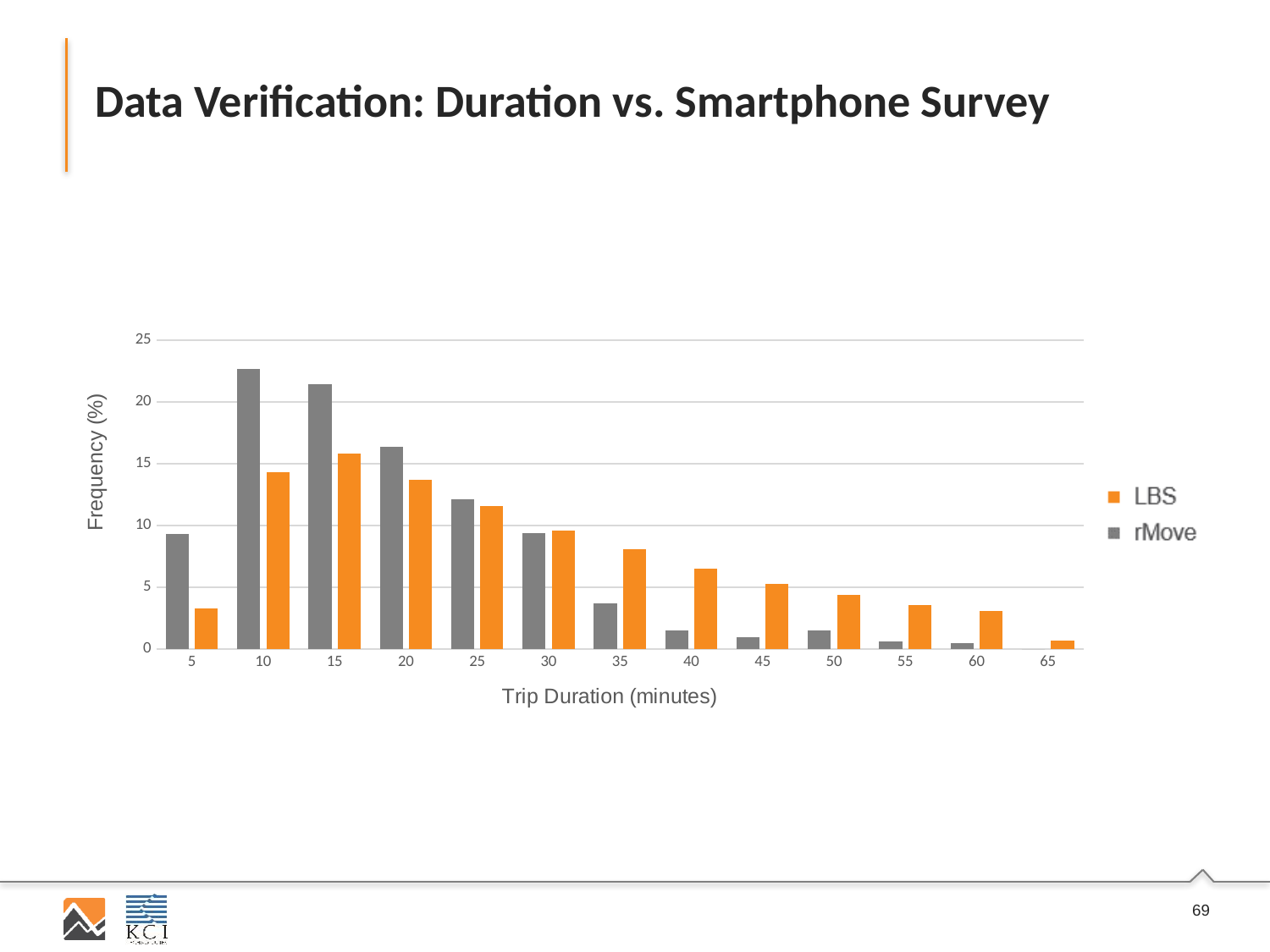
How many series does the legend list? 2 What kind of chart is shown on the slide? bar chart Is the rMove value for trip duration 35 greater or less than 5? less At trip duration 40, which series has the larger value, LBS or rMove? LBS Which trip duration has the lowest LBS frequency? 65 Which trip duration has the highest LBS frequency? 15 Is the rMove value for trip duration 10 greater or less than 20? greater At trip duration 5, which series has the larger value, LBS or rMove? rMove Which trip duration has the highest rMove frequency? 10 Is the LBS value for trip duration 5 greater or less than 5? less How many trip duration categories are shown on the x axis? 13 Do the rMove values rise or fall from trip duration 10 to 60? fall